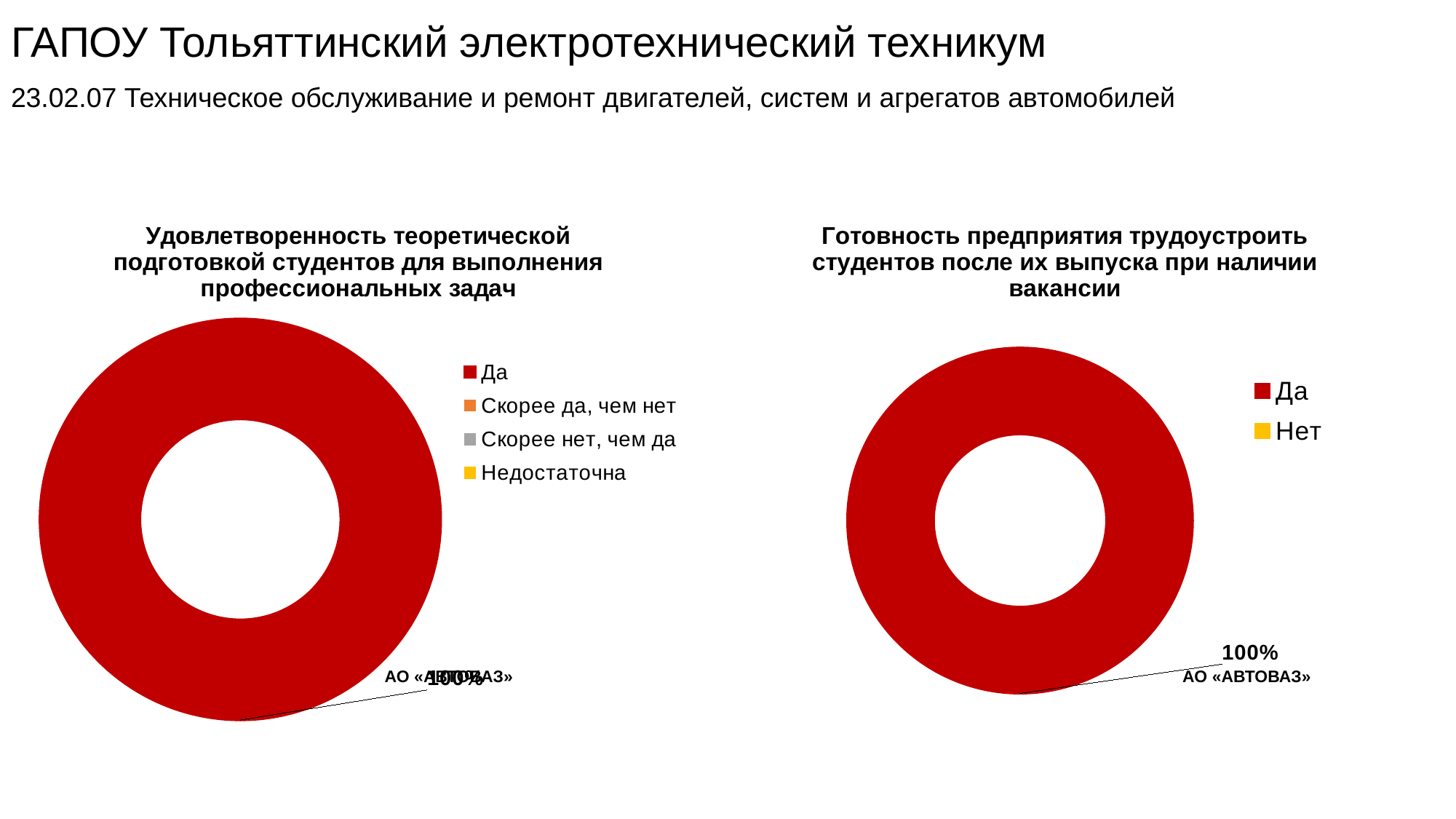
In the right chart, what is the data label shown for the "Да" slice? 100% In the right chart, how many visible slices does the doughnut have? 1 What kind of chart is the right chart, titled "Готовность предприятия трудоустроить студентов после их выпуска при наличии вакансии"? doughnut chart In the right chart, which company name is shown next to the data label? АО «АВТОВАЗ» In the left chart, which legend entry has the largest share? Да In the left chart, what share of the doughnut does the "Да" slice take? 100% What kind of chart is the left chart, titled "Удовлетворенность теоретической подготовкой студентов для выполнения профессиональных задач"? doughnut chart In the right chart, which legend entry has the largest share? Да In the right chart, what share of the doughnut does the "Да" slice take? 100% In the left chart, how many entries does the legend list? 4 In the right chart, what colour is the "Нет" legend entry? yellow In the right chart, how many entries does the legend list? 2